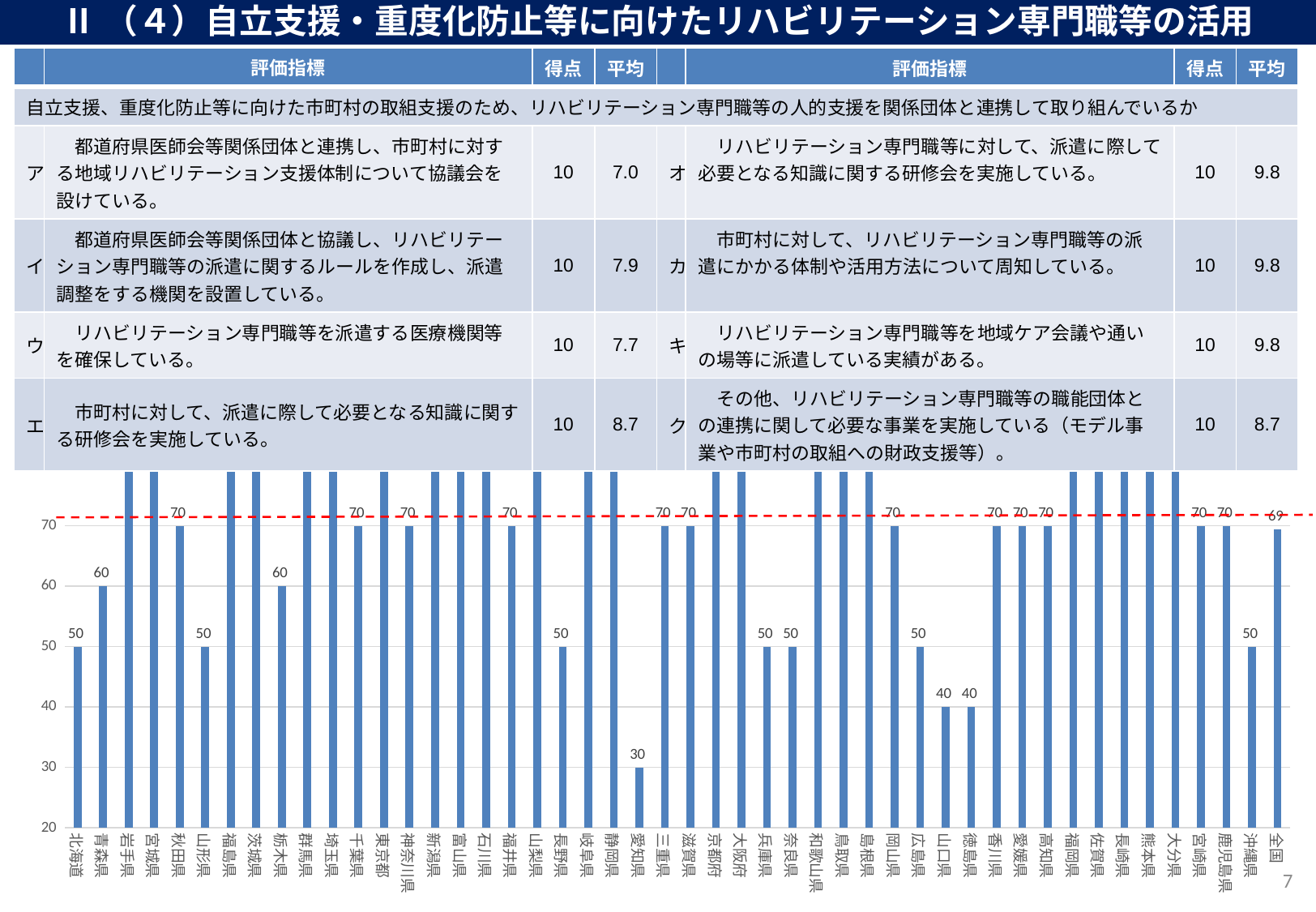
What is the difference between the values for 青森県 and 北海道 in the bar chart? 10 How many categories are shown on the x axis of the bar chart? 48 What is the value for 愛知県 in the bar chart? 30 What is the value for 全国 in the bar chart? 69 What colour is the dashed horizontal line drawn across the bar chart? red What is the value for 北海道 in the bar chart? 50 What kind of chart is shown at the bottom of the slide? bar chart Which category has the lowest value in the bar chart? 愛知県 What is the value for 山口県 in the bar chart? 40 Which is larger in the bar chart, the value for 徳島県 or the value for 愛知県? 徳島県 Is the value for 岩手県 in the bar chart greater or less than 70? greater Is the value for 沖縄県 in the bar chart greater or less than 60? less